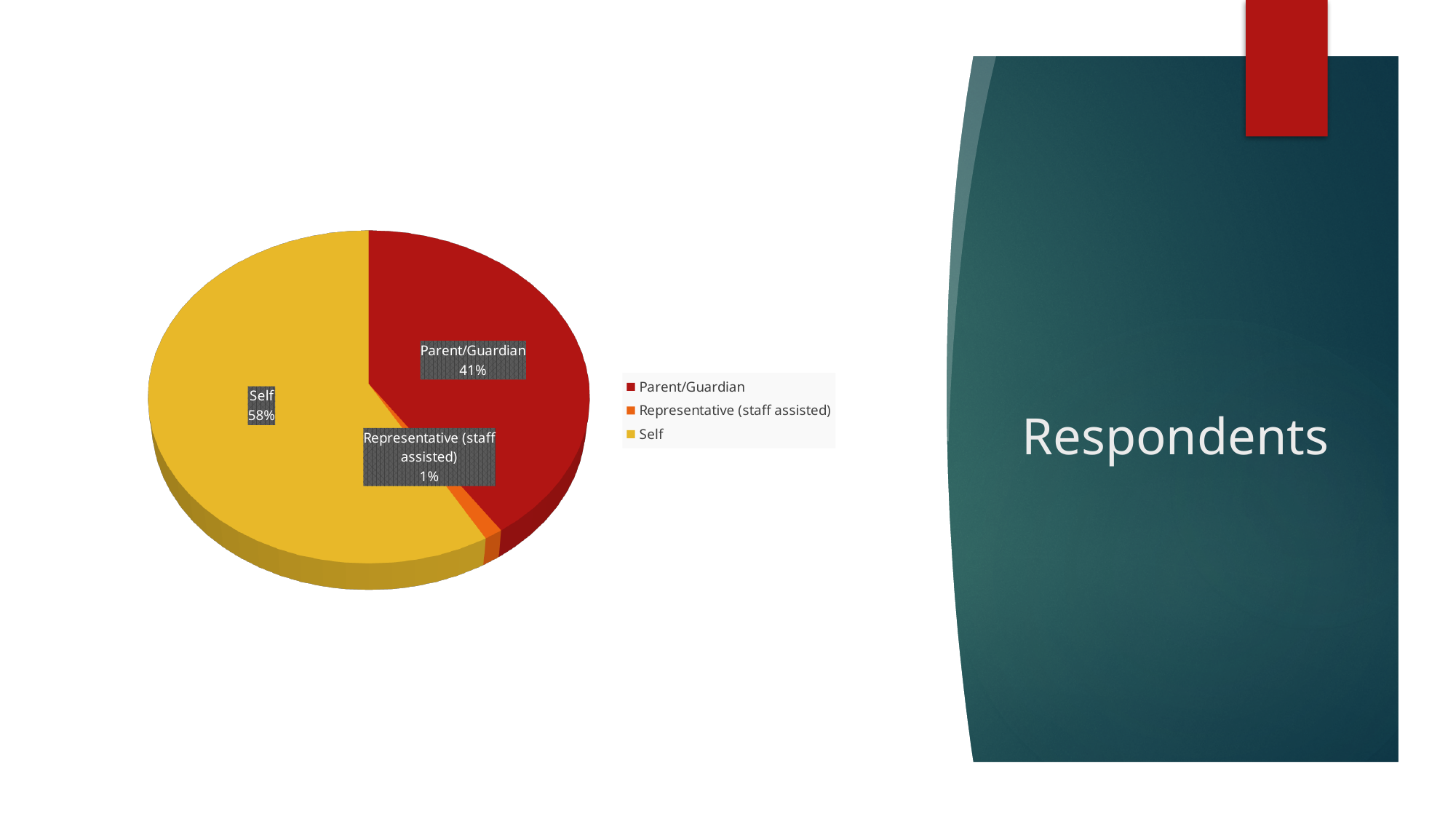
How many categories does the pie chart show? 3 What share of respondents is Representative (staff assisted)? 1% What is the difference in percentage points between Parent/Guardian and Representative (staff assisted)? 40 Which category has the smallest slice of the pie? Representative (staff assisted) What share of respondents is Self? 58% What is the title shown on the slide next to the chart? Respondents What share of respondents is Parent/Guardian? 41% What colour is the Self slice in the pie chart? yellow What is the difference in percentage points between Self and Parent/Guardian? 17 Which is larger, the Parent/Guardian slice or the Self slice? Self Which category has the largest slice of the pie? Self What kind of chart is shown on the slide? pie chart